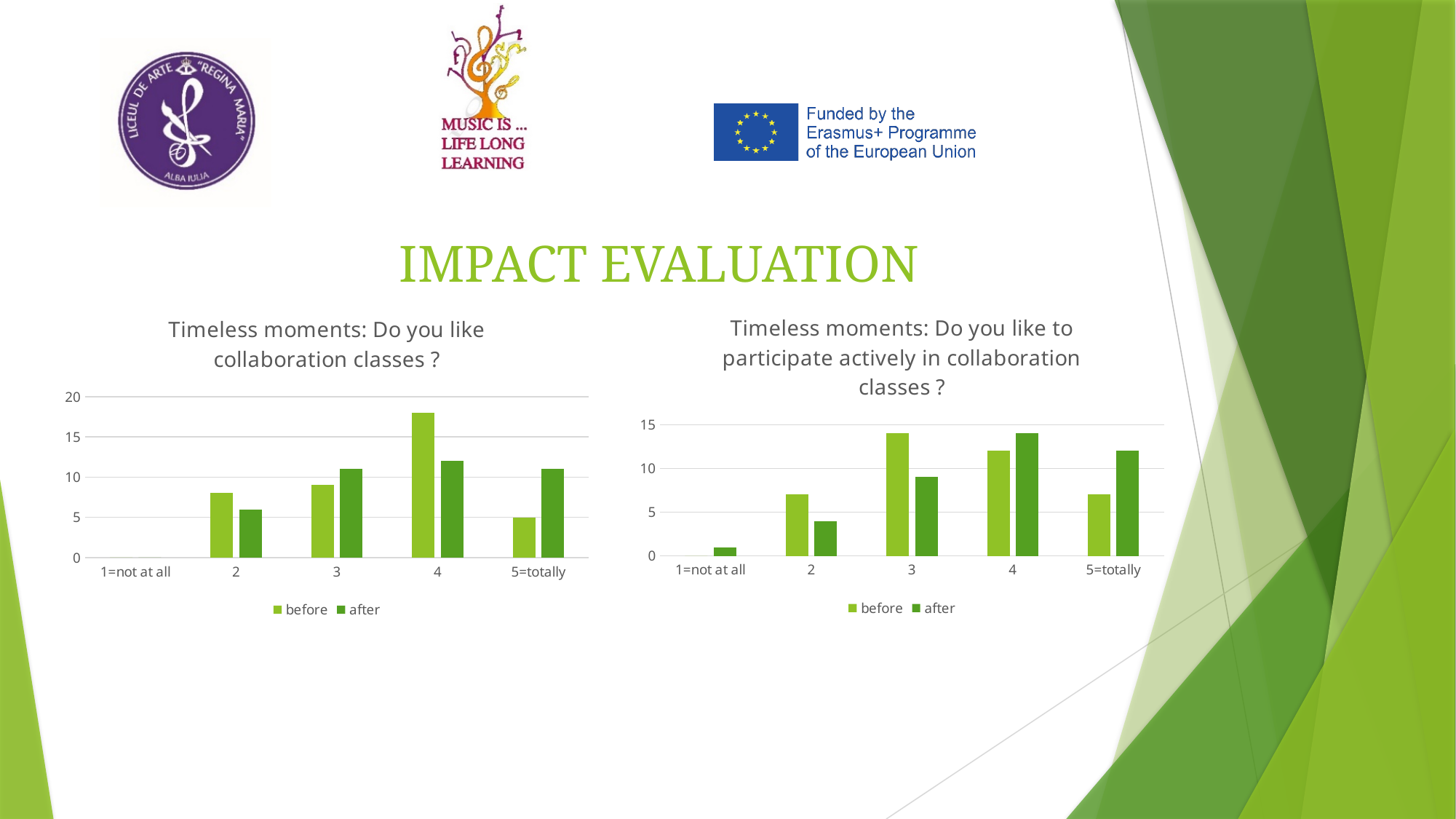
What kind of chart is the left chart 'Do you like collaboration classes?'? bar chart How many categories are shown on the x axis of the right chart 'Do you like to participate actively in collaboration classes?'? 5 In the right chart 'Do you like to participate actively in collaboration classes?', which is larger for 5=totally, 'before' or 'after'? after In the left chart 'Do you like collaboration classes?', what is the 'before' value for 5=totally? 5 In the left chart 'Do you like collaboration classes?', is the 'after' value for category 2 greater or less than 10? less In the left chart 'Do you like collaboration classes?', which category has the highest 'before' value? 4 In the right chart 'Do you like to participate actively in collaboration classes?', which category has the lowest 'after' value? 1=not at all In the right chart 'Do you like to participate actively in collaboration classes?', is the 'after' value for category 4 greater or less than 10? greater In the left chart 'Do you like collaboration classes?', which is larger for 5=totally, 'before' or 'after'? after In the left chart 'Do you like collaboration classes?', is the 'before' value for category 4 greater or less than 15? greater In the right chart 'Do you like to participate actively in collaboration classes?', which category has the highest 'before' value? 3 In the left chart 'Do you like collaboration classes?', how many series does the legend list? 2